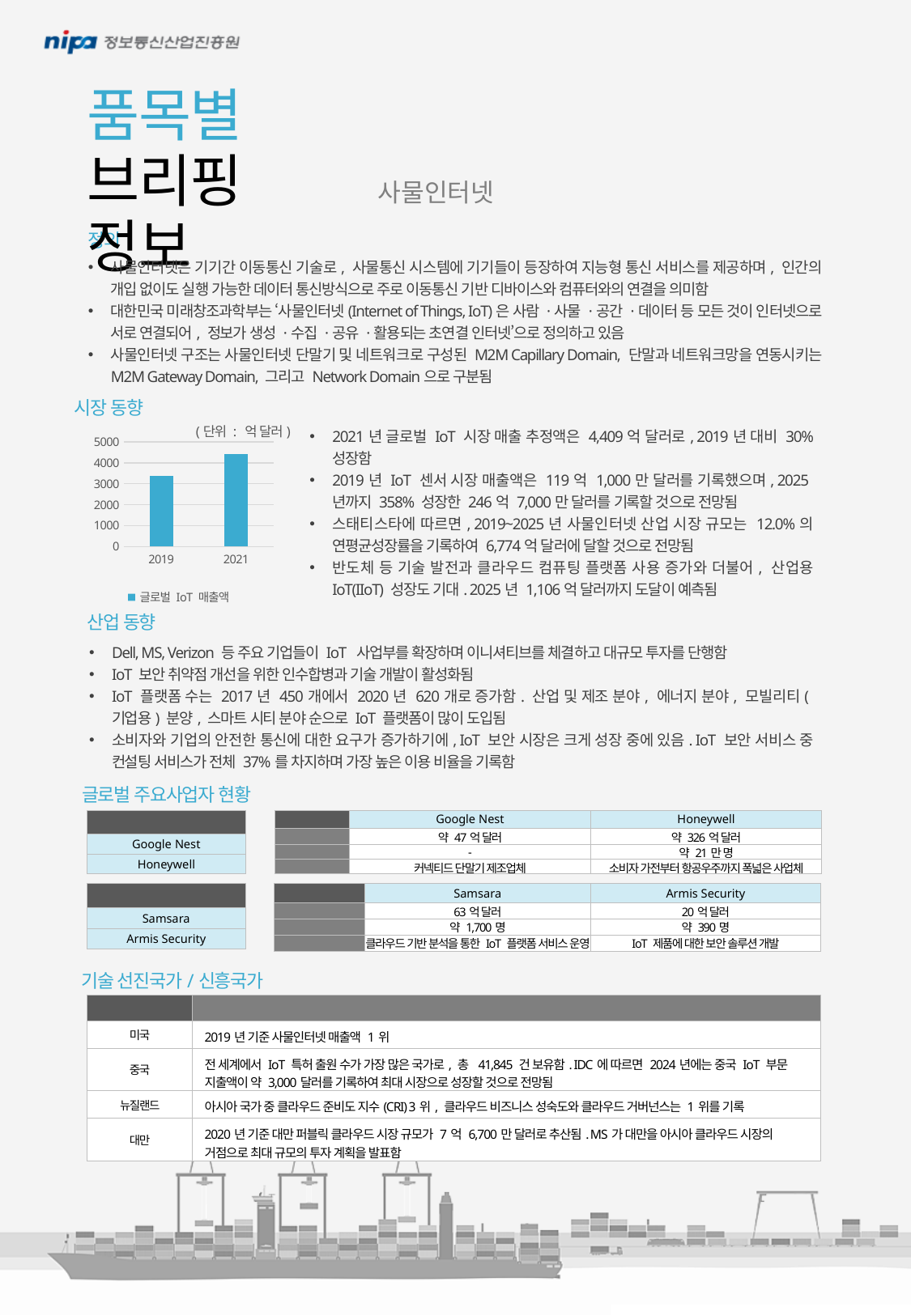
Which year has the lowest bar on the chart? 2019 What is the legend entry of the bar chart? 글로벌 IoT 매출액 How many categories (years) are plotted on the bar chart? 2 What kind of chart is shown in the 시장 동향 section? bar chart Is the bar for 2019 greater or less than 4000? less Which year has the highest bar on the chart? 2021 How many series does the legend of the bar chart list? 1 Is the bar for 2021 greater or less than 4000? greater What unit is stated above the bar chart? 억 달러 Is the bar for 2019 greater or less than 3000? greater Do the values on the bar chart rise or fall from 2019 to 2021? rise Which is larger on the chart, the value for 2019 or the value for 2021? 2021